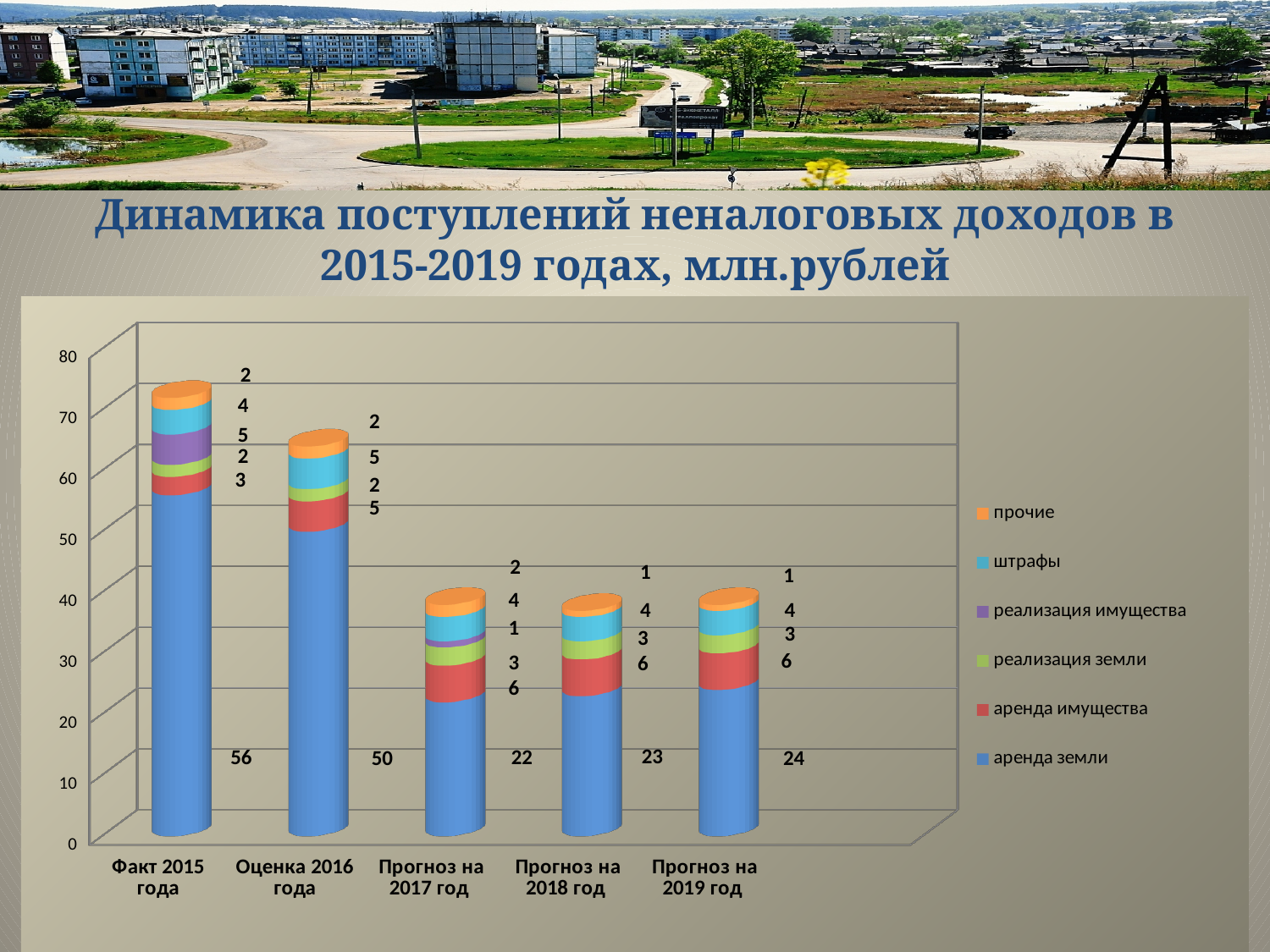
Which has the larger аренда имущества value, Оценка 2016 года or Прогноз на 2017 год? Прогноз на 2017 год What is the value of реализация имущества for Факт 2015 года? 5 How many series does the legend list? 6 How many categories are shown on the x axis? 5 Which category has the highest value for аренда земли? Факт 2015 года What is the value of аренда имущества for Прогноз на 2018 год? 6 Which category has the lowest value for аренда земли? Прогноз на 2017 год Does the аренда земли value rise or fall from Прогноз на 2017 год to Прогноз на 2019 год? Rise What is the difference between the аренда земли values for Факт 2015 года and Оценка 2016 года? 6 What is the value of аренда земли for Факт 2015 года? 56 What is the value of аренда земли for Прогноз на 2019 год? 24 What kind of chart is shown on the slide? Stacked bar chart